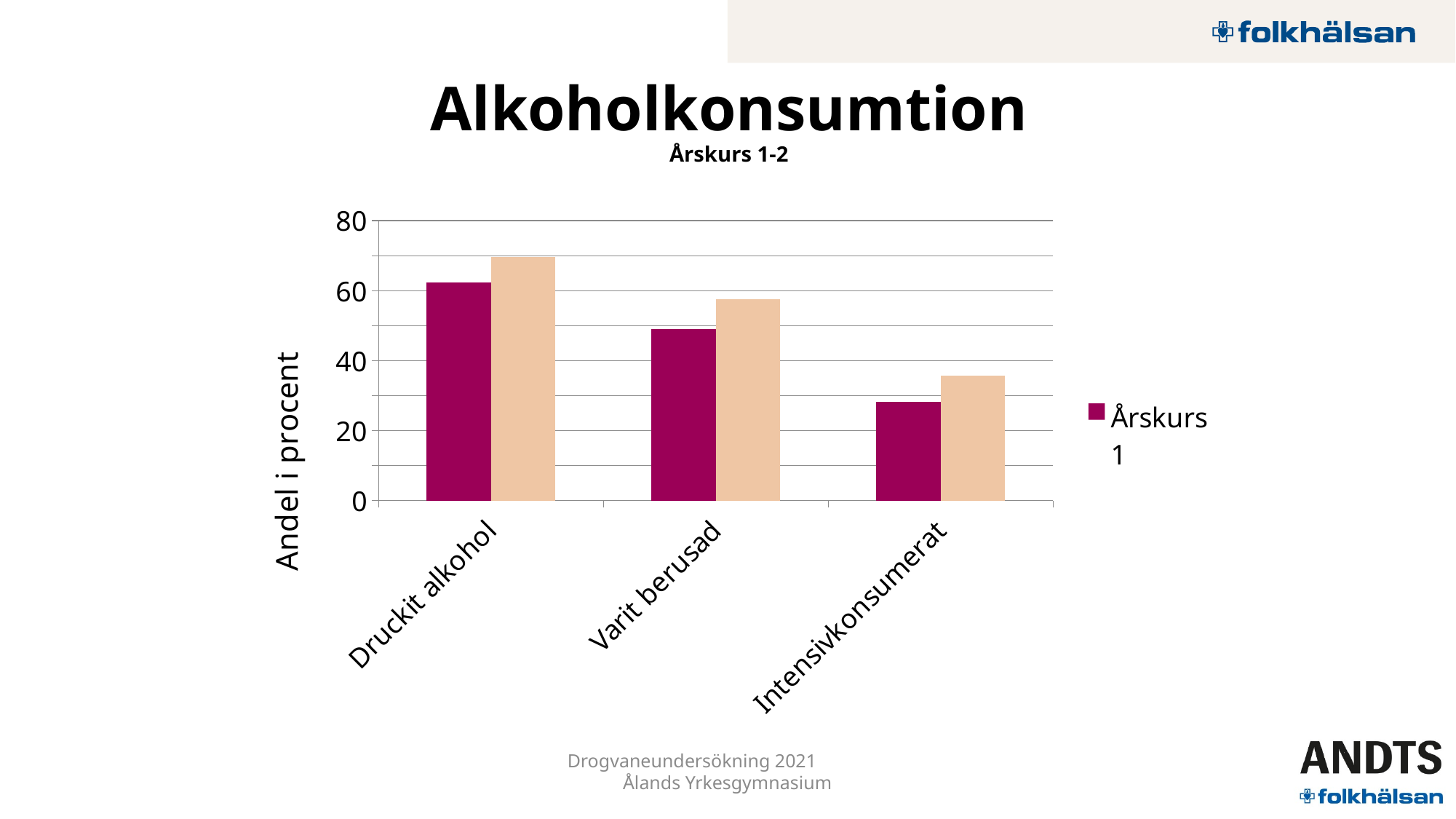
Is the Årskurs 1 value for Intensivkonsumerat greater or less than 40? less What is the label on the vertical axis? Andel i procent How many categories are shown on the x axis? 3 What is the subtitle shown under the chart title Alkoholkonsumtion? Årskurs 1-2 Is the Årskurs 1 value for Varit berusad greater or less than 60? less Which category has the lowest value for Årskurs 1? Intensivkonsumerat How many bars are plotted for each category? 2 Is the Årskurs 1 value for Druckit alkohol greater or less than 40? greater Do the Årskurs 1 values rise or fall from Druckit alkohol to Intensivkonsumerat? fall Which category has the highest value for Årskurs 1? Druckit alkohol For Årskurs 1, which is larger: Druckit alkohol or Intensivkonsumerat? Druckit alkohol What kind of chart is shown on the slide? Bar chart